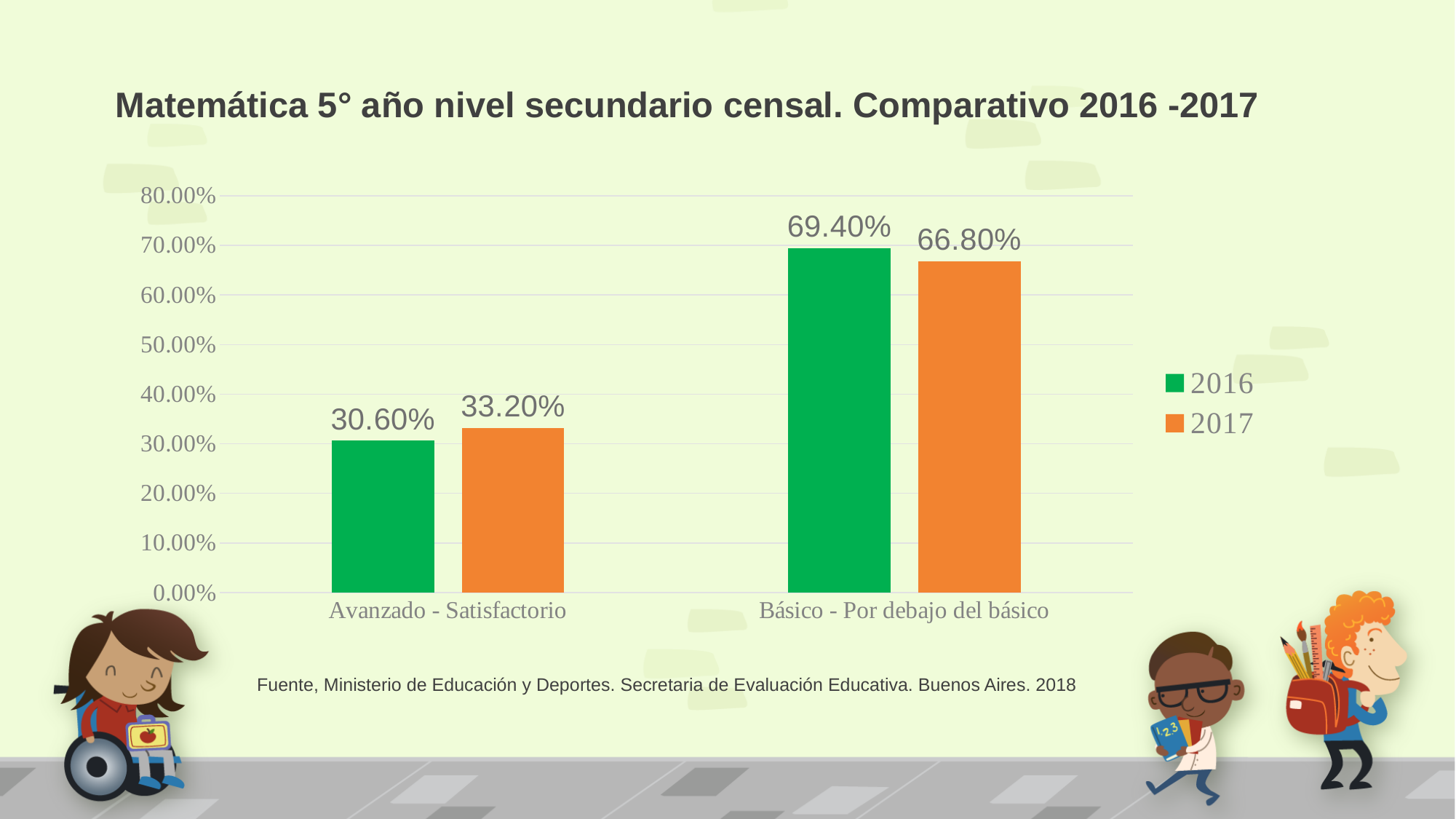
How many categories are shown on the x axis? 2 How many series does the legend list? 2 What is the 2016 value for Avanzado - Satisfactorio? 30.60% Which colour represents the 2017 series in the legend? Orange Which category has the lowest 2017 value? Avanzado - Satisfactorio What is the 2017 value for Básico - Por debajo del básico? 66.80% Which is larger for Avanzado - Satisfactorio: the 2016 value or the 2017 value? 2017 What is the 2016 value for Básico - Por debajo del básico? 69.40% What kind of chart is shown on the slide? Bar chart Which category has the highest 2016 value? Básico - Por debajo del básico What is the difference between the 2016 and 2017 values for Básico - Por debajo del básico? 2.60% What is the 2017 value for Avanzado - Satisfactorio? 33.20%